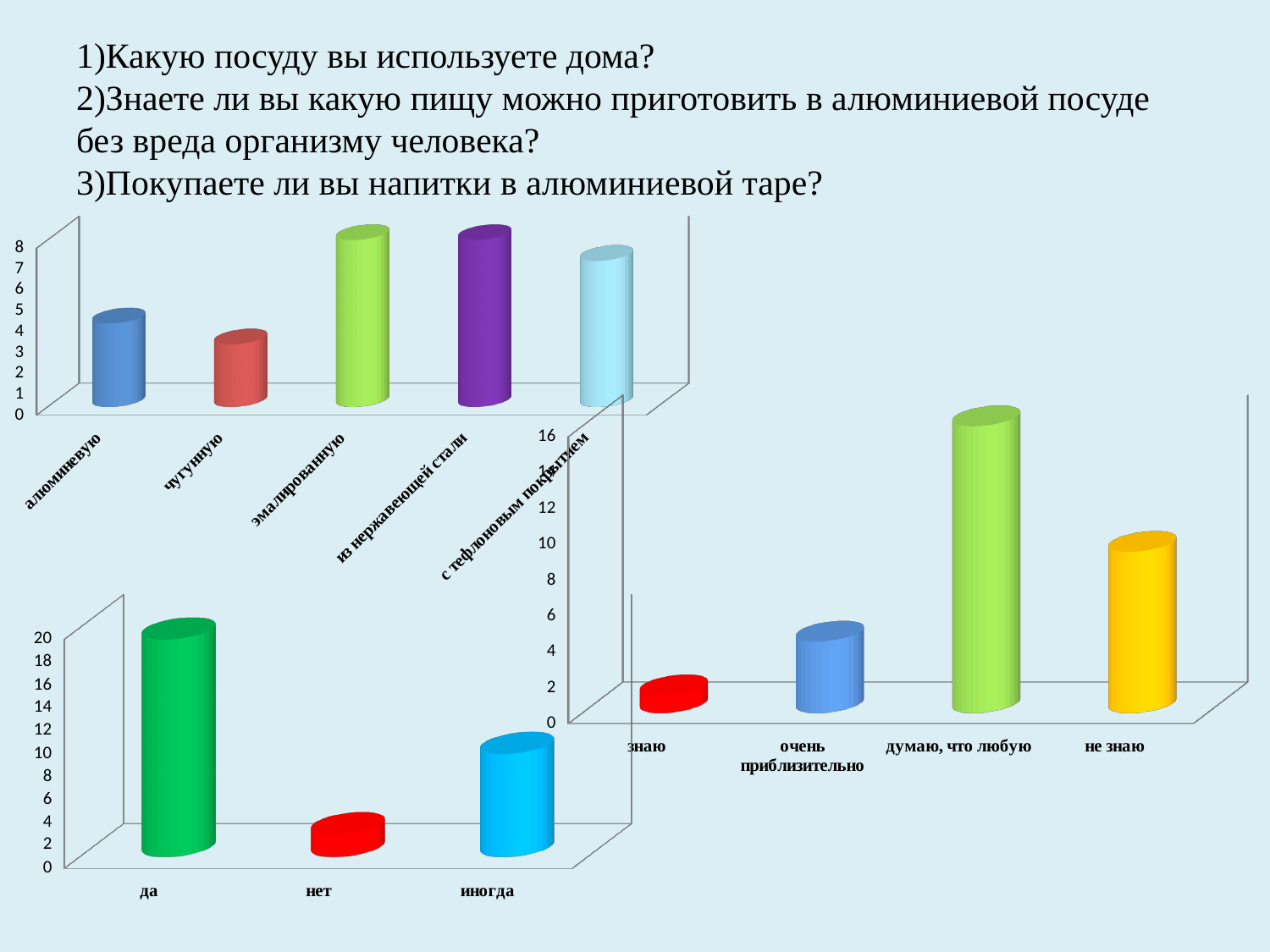
In the top-left chart, is the value for эмалированную greater or less than 6? greater In the top-left chart, is the value for чугунную greater or less than 6? less In the bottom-left chart, is the value for нет greater or less than 4? less In the top-left chart, which is larger, the value for алюминиевую or the value for эмалированную? эмалированную In the bottom-left chart, which category has the lowest value? нет In the bottom-left chart, which category has the highest value? да In the right chart, which category has the highest value? думаю, что любую What kind of chart is the right chart? bar chart In the right chart, which category has the lowest value? знаю In the top-left chart, how many categories of cookware are shown? 5